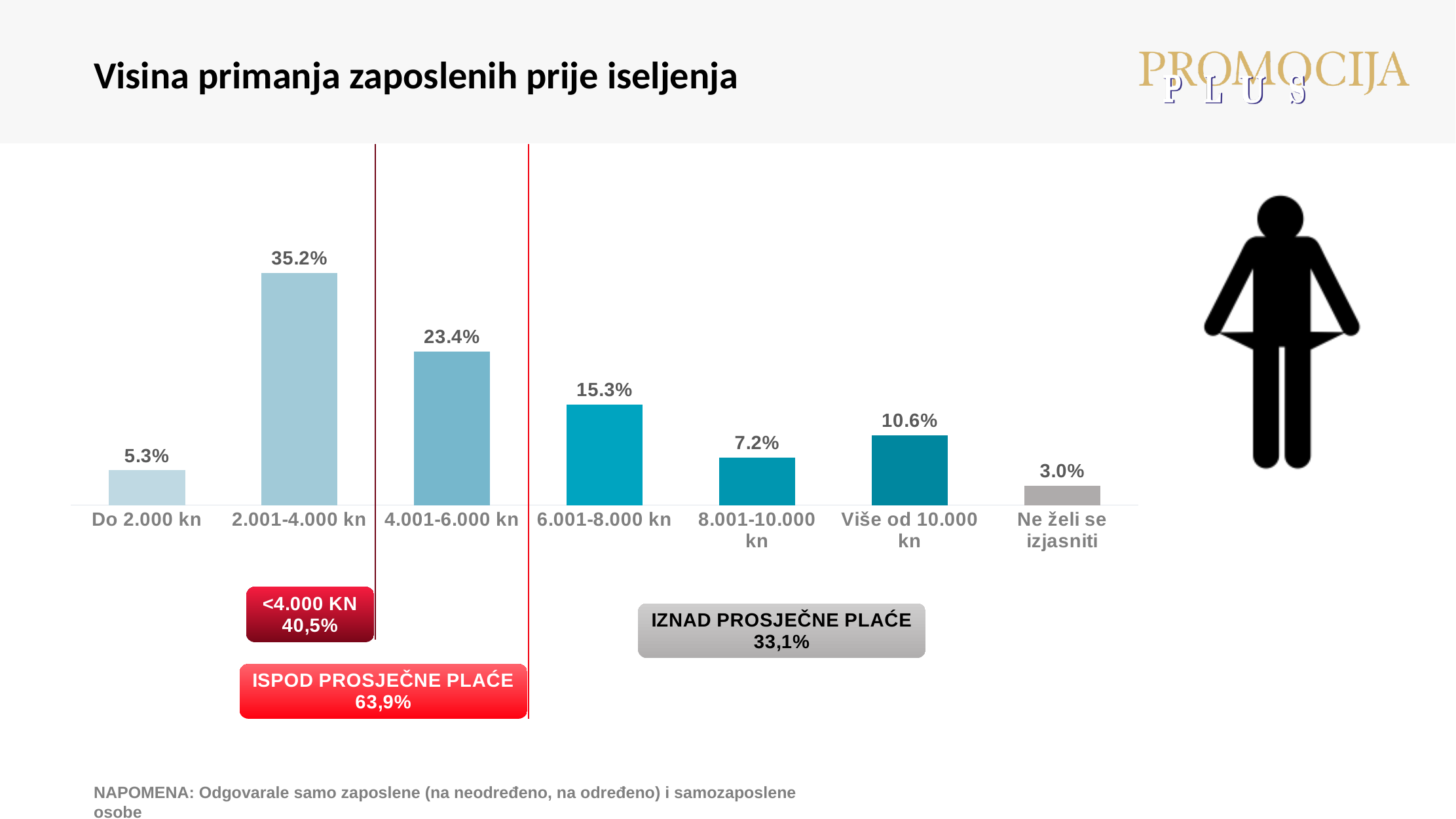
Which category has the highest value? 2.001-4.000 kn What kind of chart is shown on the slide? bar chart What is the value for the '2.001-4.000 kn' category? 35.2% Which is larger: the value for 'Više od 10.000 kn' or the value for '8.001-10.000 kn'? Više od 10.000 kn How many categories are shown on the x axis? 7 What is the difference between the values for '4.001-6.000 kn' and '6.001-8.000 kn'? 8.1% What is the title of the slide? Visina primanja zaposlenih prije iseljenja What is the difference between the values for 'Do 2.000 kn' and '2.001-4.000 kn'? 29.9% Which category has the lowest value? Ne želi se izjasniti What is the value for the '8.001-10.000 kn' category? 7.2% What percentage is shown in the 'ISPOD PROSJEČNE PLAĆE' box below the chart? 63,9% What is the value for the 'Ne želi se izjasniti' category? 3.0%